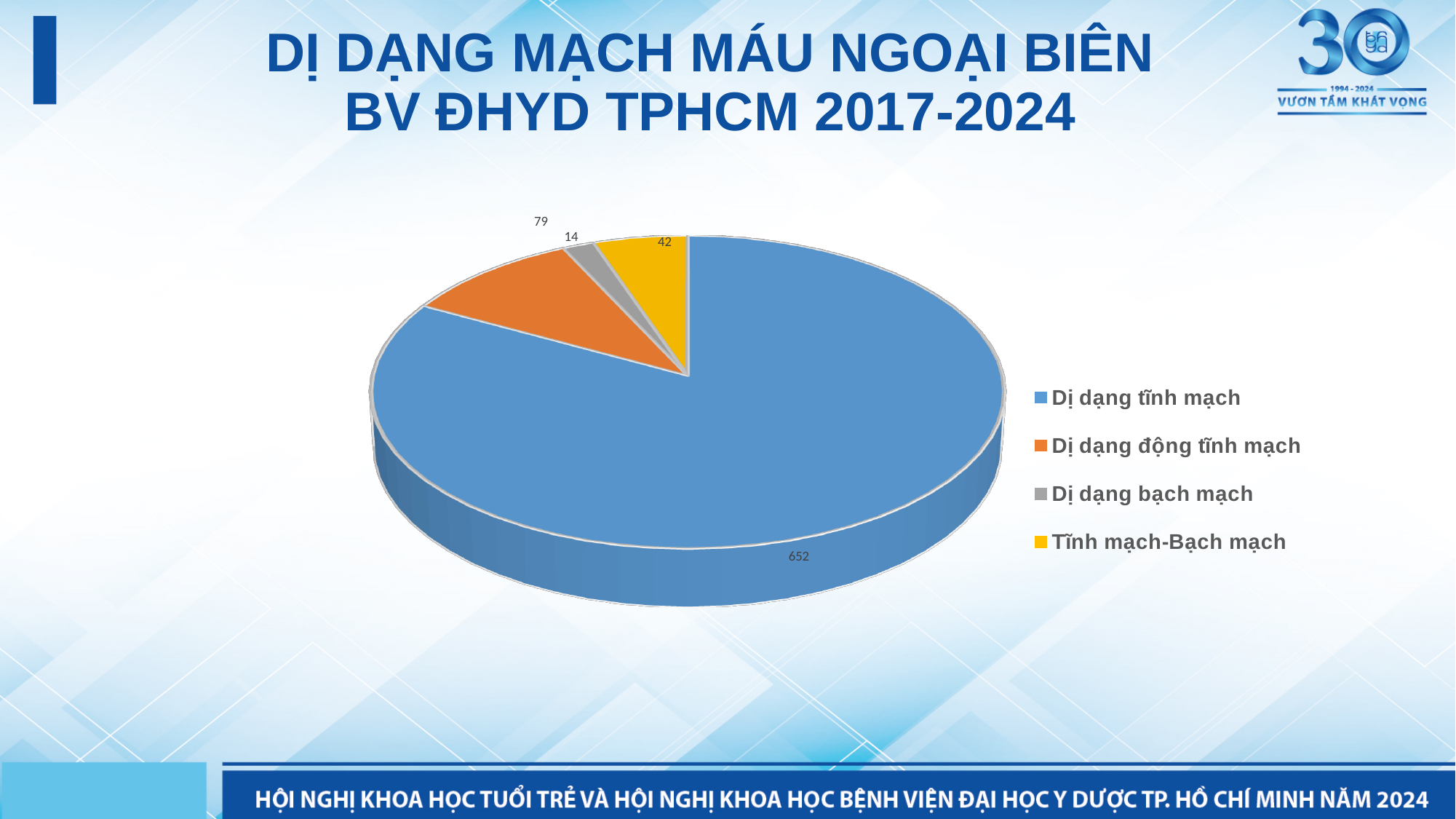
Which category has the smallest slice of the pie? Dị dạng bạch mạch How many categories does the pie chart have? 4 Which category has the largest slice of the pie? Dị dạng tĩnh mạch What is the total of all the slices in the pie chart? 787 What is the value for Dị dạng bạch mạch? 14 What colour is the slice for Dị dạng động tĩnh mạch? Orange What kind of chart is shown on the slide? Pie chart What is the value for Dị dạng động tĩnh mạch? 79 Which is larger, the value for Tĩnh mạch-Bạch mạch or the value for Dị dạng bạch mạch? Tĩnh mạch-Bạch mạch What is the value for Tĩnh mạch-Bạch mạch? 42 What is the value for Dị dạng tĩnh mạch? 652 What is the difference between the values for Dị dạng động tĩnh mạch and Tĩnh mạch-Bạch mạch? 37